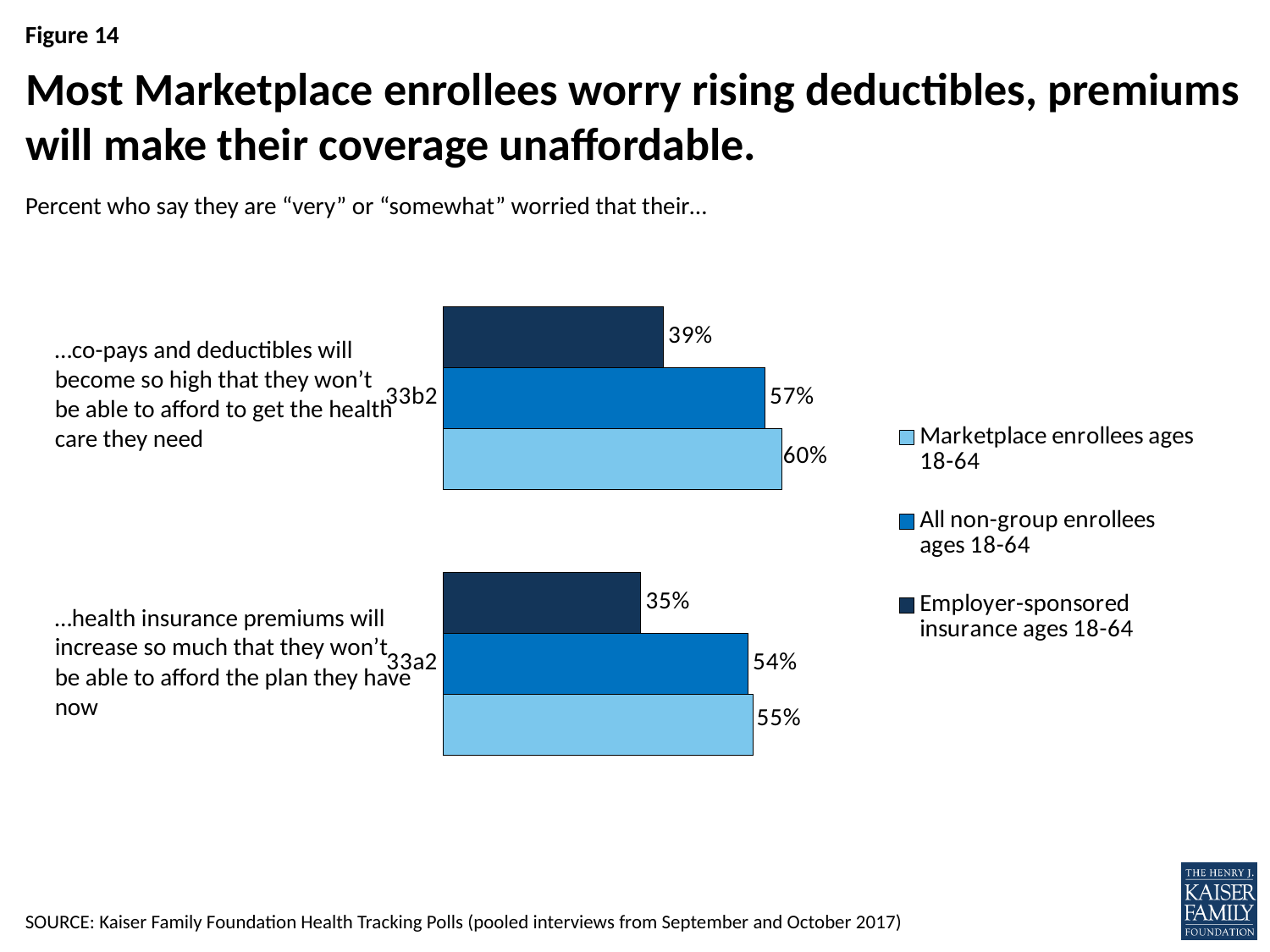
Which colour represents Employer-sponsored insurance ages 18-64 in the chart? dark navy blue What kind of chart is shown on the slide? bar chart Which group has the highest share worried that co-pays and deductibles will become unaffordable? Marketplace enrollees ages 18-64 How many series does the legend list? 3 What percent of Marketplace enrollees ages 18-64 are worried that co-pays and deductibles will become so high that they won't be able to afford to get the health care they need? 60% What percent of All non-group enrollees ages 18-64 are worried that premiums will increase so much that they won't be able to afford their current plan? 54% What is the difference between Marketplace enrollees and Employer-sponsored insurance enrollees in the share worried about co-pays and deductibles becoming unaffordable? 21 percentage points What percent of Employer-sponsored insurance ages 18-64 are worried that health insurance premiums will increase so much that they won't be able to afford the plan they have now? 35% What is the difference between All non-group enrollees and Employer-sponsored insurance enrollees in the share worried about premiums increasing? 19 percentage points Which group has the lowest share worried that premiums will increase so much they can't afford their current plan? Employer-sponsored insurance ages 18-64 Is the share of Employer-sponsored insurance enrollees worried about co-pays and deductibles larger or smaller than the share worried about premiums increasing? larger What percent of All non-group enrollees ages 18-64 are worried that co-pays and deductibles will become so high that they won't be able to afford care? 57%